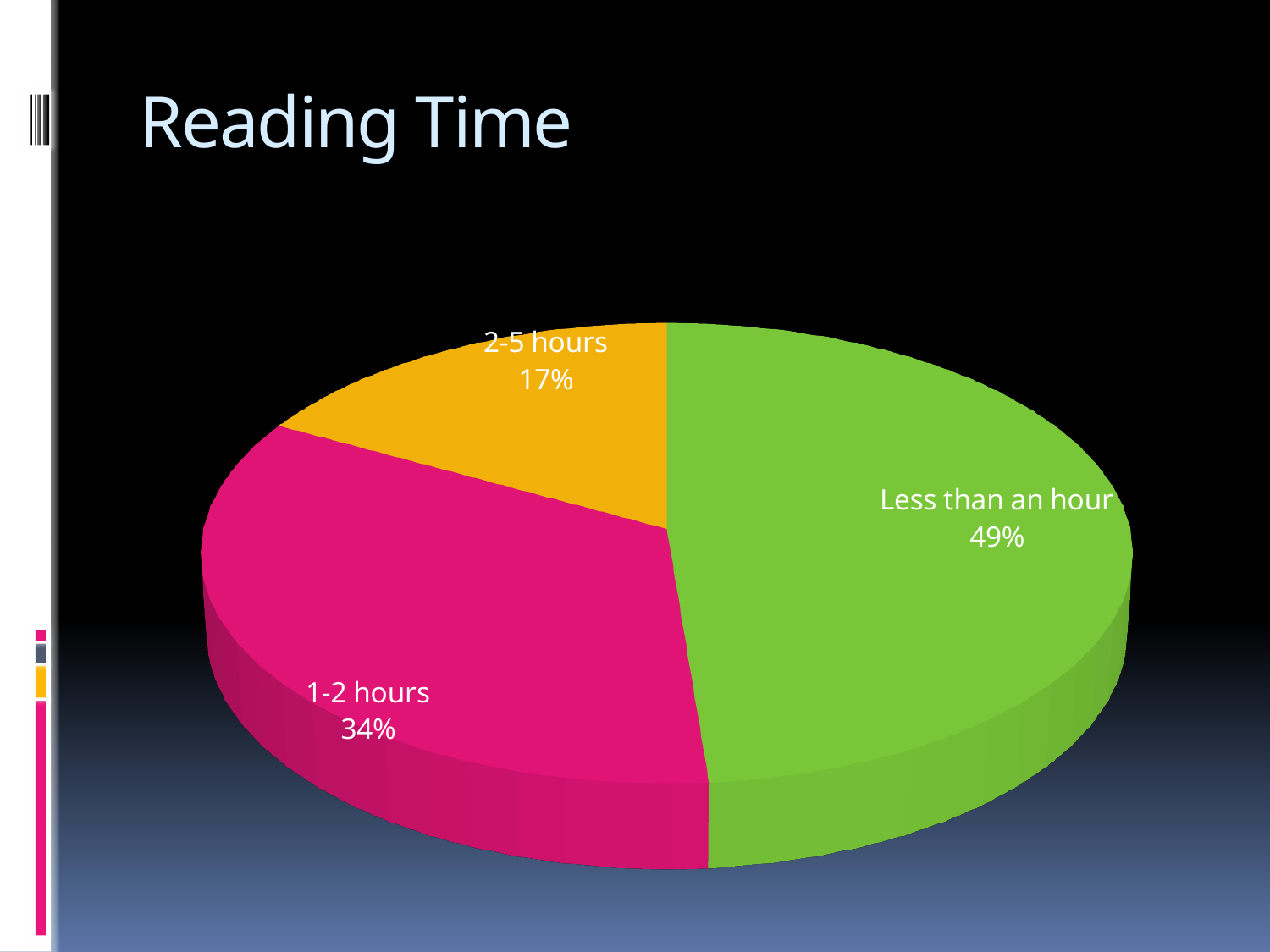
Which is larger, the "1-2 hours" slice or the "2-5 hours" slice? 1-2 hours What share of the pie is labelled "1-2 hours"? 34% What kind of chart is shown on the slide? pie chart What share of the pie is labelled "Less than an hour"? 49% What is the difference in percentage points between the "Less than an hour" slice and the "1-2 hours" slice? 15 What colour is the "Less than an hour" slice? green What is the title of the slide containing the pie chart? Reading Time Which category has the largest slice of the pie? Less than an hour What share of the pie is labelled "2-5 hours"? 17% Which category has the smallest slice of the pie? 2-5 hours How many slices does the pie chart have? 3 What is the difference in percentage points between the "1-2 hours" slice and the "2-5 hours" slice? 17